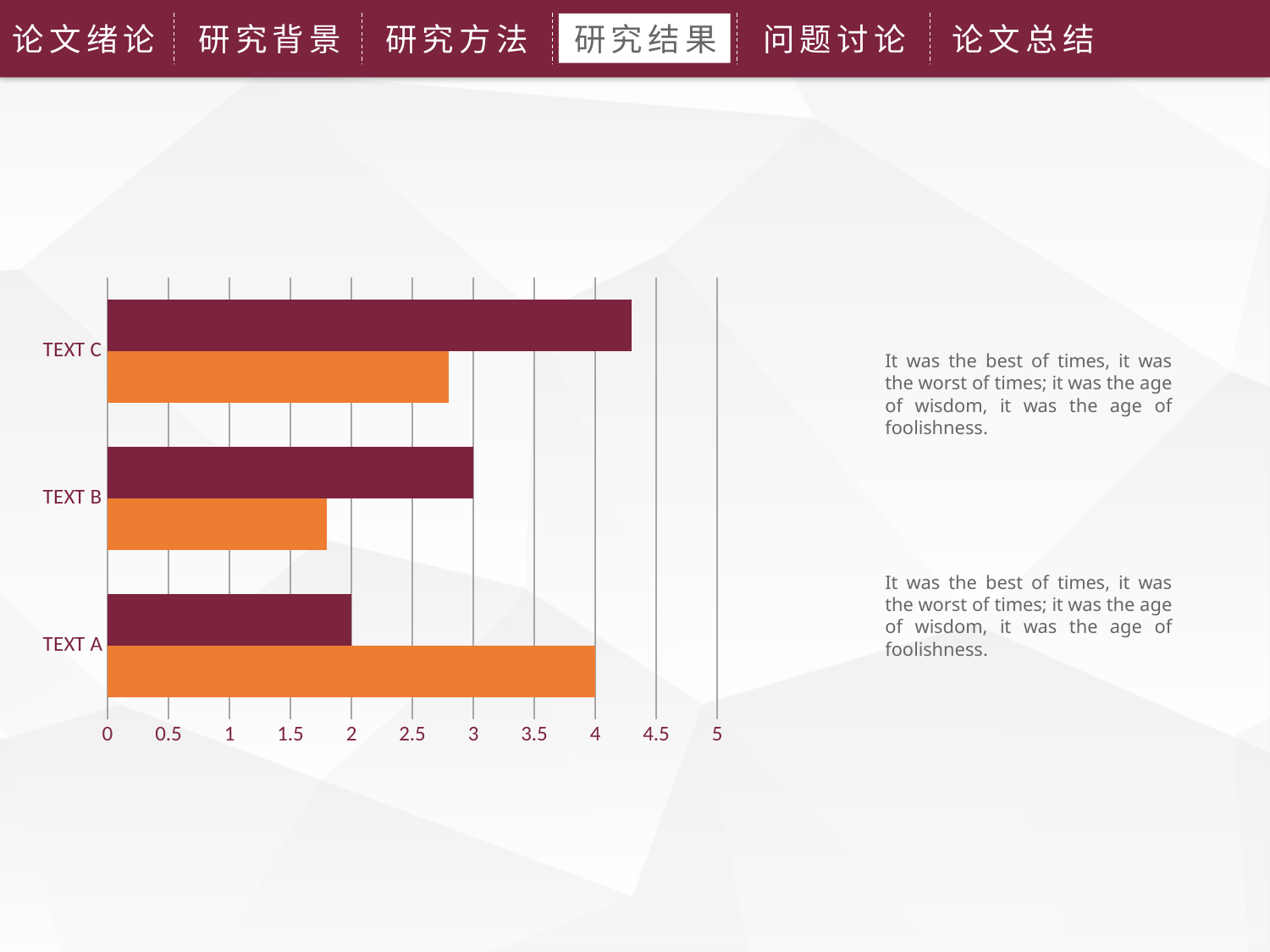
What is the value of the orange bar for TEXT A? 4 For TEXT A, which bar is larger, the orange bar or the dark red bar? the orange bar Is the value of the dark red bar for TEXT C greater or less than 4? greater What is the value of the dark red bar for TEXT A? 2 How many data series are plotted for each category on the chart? 2 What kind of chart is shown on the slide? bar chart How many categories are shown on the chart? 3 Is the value of the orange bar for TEXT B greater or less than 2? less What is the value of the dark red bar for TEXT B? 3 Which category has the lowest orange bar? TEXT B Is the value of the orange bar for TEXT C greater or less than 3? less Which category has the highest dark red bar? TEXT C